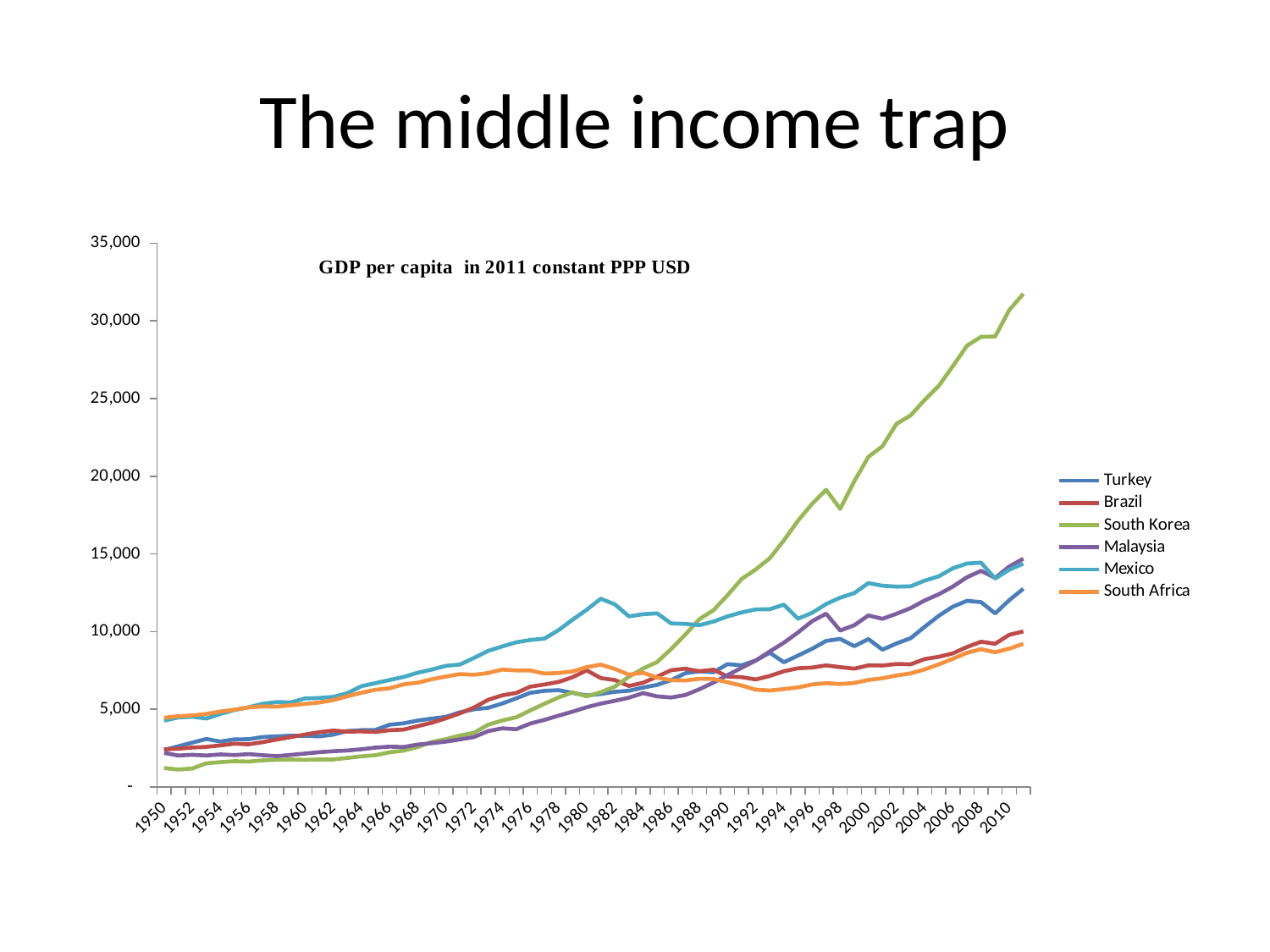
Is Malaysia's GDP per capita at the end of the series greater or less than 10,000? greater Is South Korea's GDP per capita at the end of the series greater or less than 30,000? greater Is South Korea's GDP per capita in 1950 greater or less than 5,000? less What is the title printed inside the chart area? GDP per capita in 2011 constant PPP USD What kind of chart is shown on the slide? line chart Does South Korea's GDP per capita rise or fall overall from 1950 to the end of the series? rise Which country has the highest GDP per capita at the end of the series (2010s)? South Korea Which country had the lowest GDP per capita in 1950? South Korea In 1950, which had the higher GDP per capita, Mexico or South Korea? Mexico How many series does the legend list? 6 At the end of the series, which has the higher GDP per capita, Mexico or Turkey? Mexico